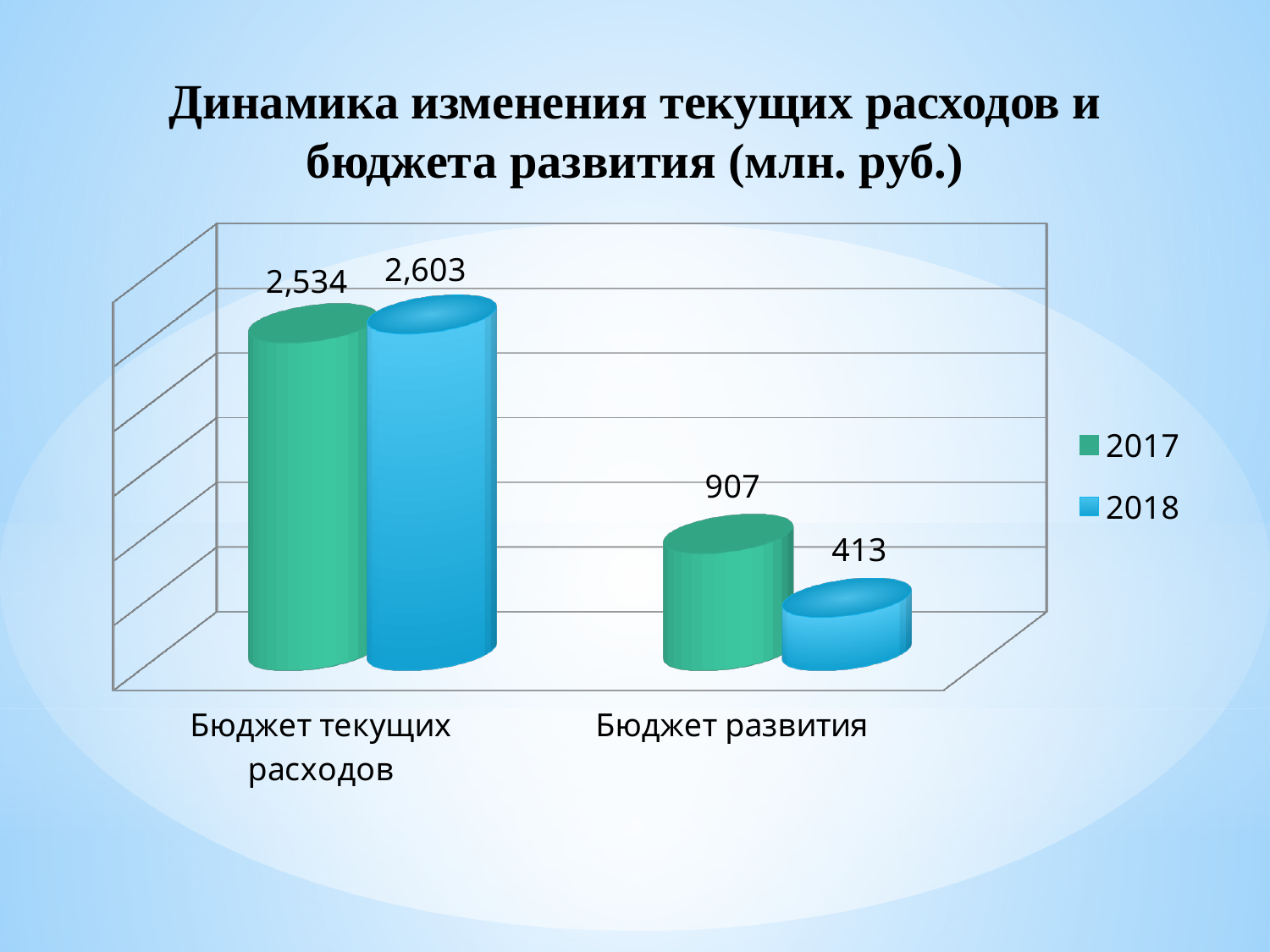
Which category has the lowest value in 2017? Бюджет развития What is the value for Бюджет текущих расходов in 2017? 2,534 How many categories are shown on the x axis? 2 What is the difference between the 2018 and 2017 values for Бюджет текущих расходов? 69 Which category has the highest value in 2018? Бюджет текущих расходов What is the value for Бюджет развития in 2018? 413 How many series does the legend list? 2 What is the difference between the 2017 and 2018 values for Бюджет развития? 494 What is the value for Бюджет текущих расходов in 2018? 2,603 What kind of chart is shown on the slide? Bar chart What is the value for Бюджет развития in 2017? 907 For Бюджет развития, which year has the larger value, 2017 or 2018? 2017